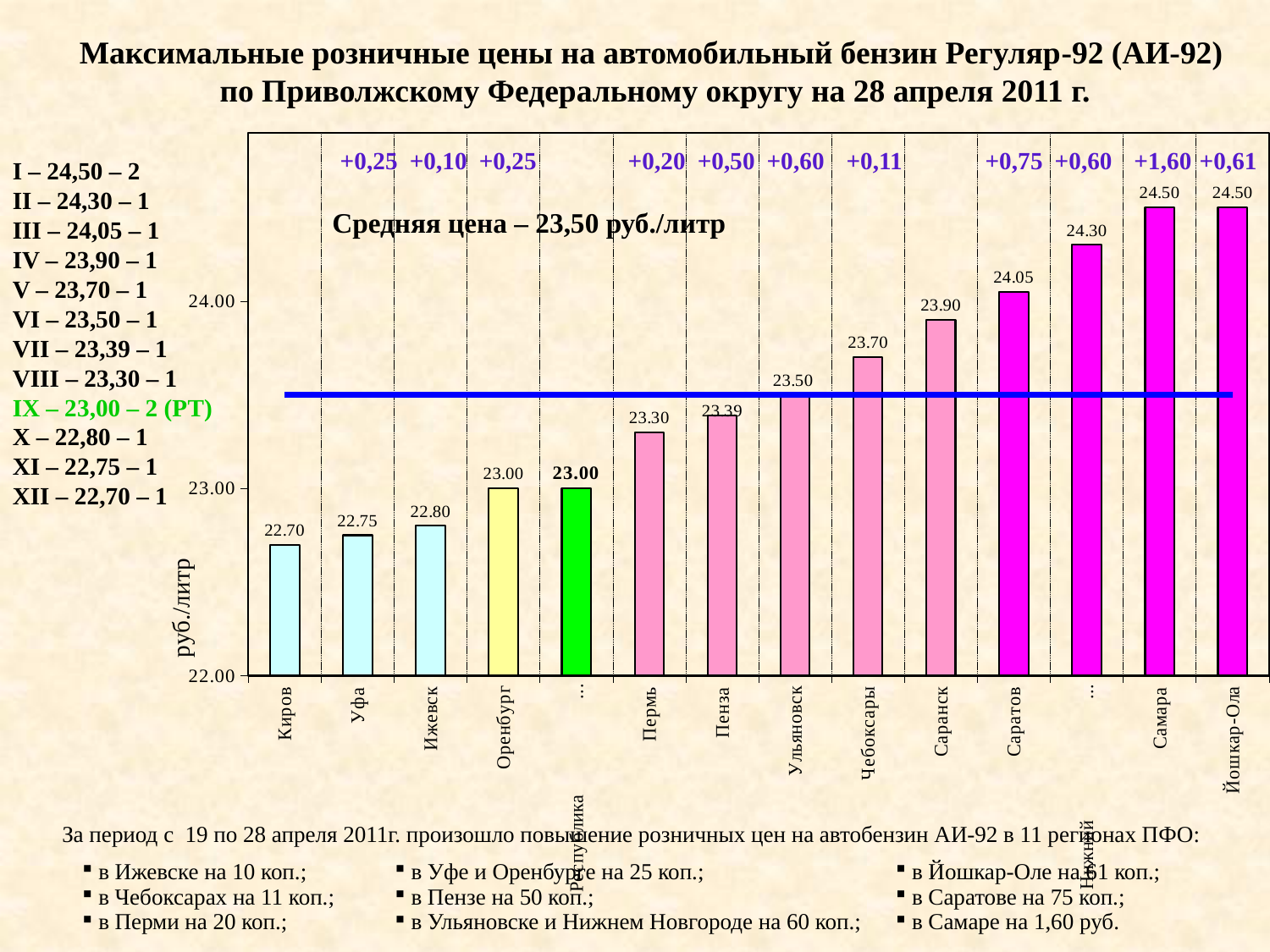
What is the value for Пенза? 23.39 Which is larger, the value for Чебоксары or the value for Пермь? Чебоксары How many bars are shown in the chart? 14 What is the value for Киров? 22.70 Is the value for Ижевск greater or less than 23.00? less What is the difference between the values for Саратов and Ульяновск? 0.55 What is the value for Саранск? 23.90 Do the values rise or fall from left to right along the x axis? rise What is the difference between the values for Самара and Киров? 1.80 Which city has the lowest value? Киров What average price is stated on the chart? 23,50 руб./литр What kind of chart is shown on the slide? bar chart